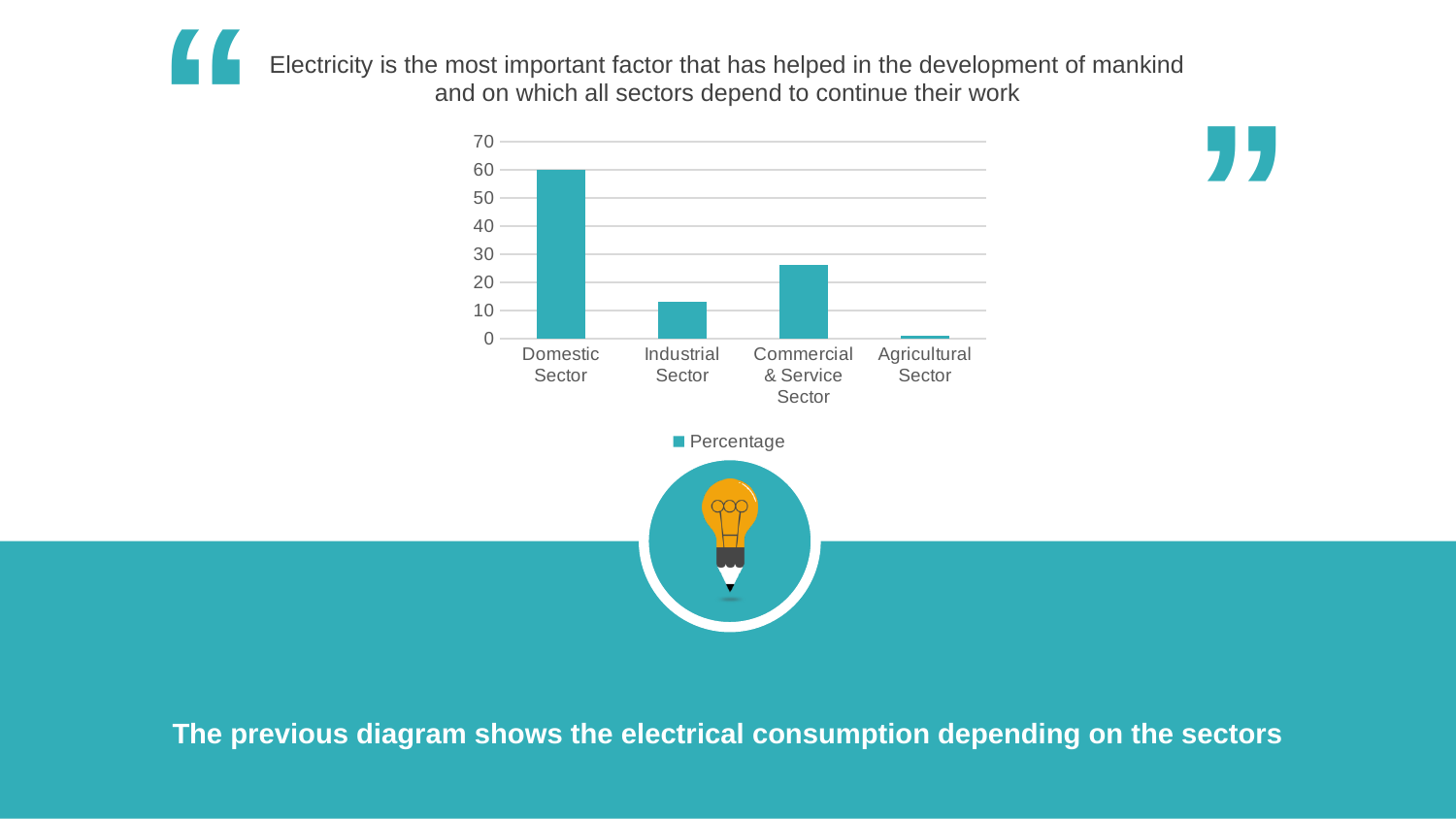
What is the value for the Domestic Sector in the chart? 60 Is the value for the Commercial & Service Sector greater or less than 20? greater What is the name of the series shown in the chart's legend? Percentage How many sectors are shown on the x axis of the chart? 4 Which is larger, the value for the Industrial Sector or the Commercial & Service Sector? Commercial & Service Sector What is the highest value shown on the chart's vertical axis? 70 Is the value for the Industrial Sector greater or less than 20? less Is the value for the Agricultural Sector greater or less than 10? less Which sector has the highest bar in the chart? Domestic Sector What kind of chart is shown on the slide? bar chart Which sector has the lowest bar in the chart? Agricultural Sector How many series does the chart's legend list? 1